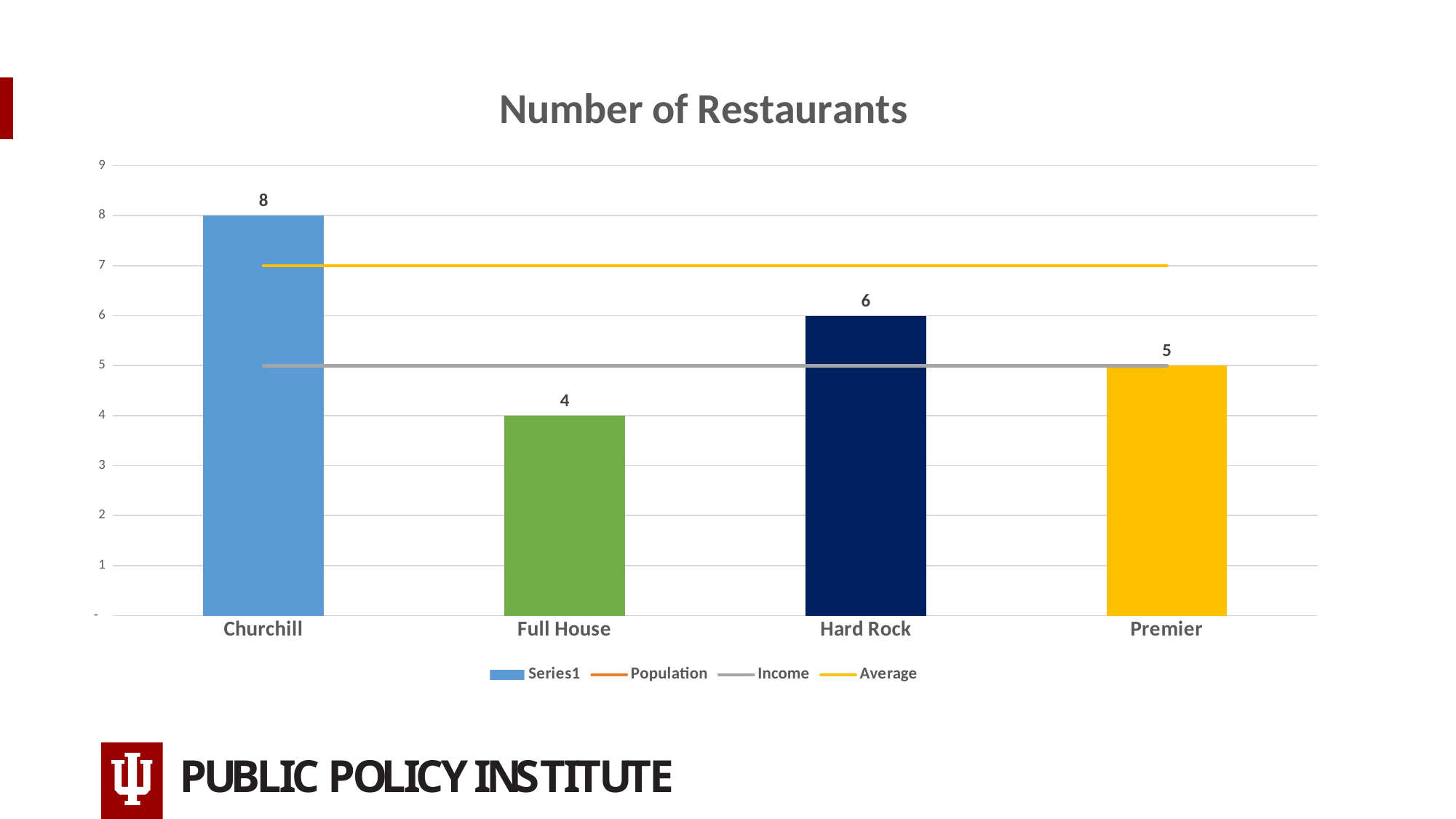
How many series does the legend list? 4 Which has more restaurants, Hard Rock or Premier? Hard Rock What is the difference between the number of restaurants for Churchill and Full House? 4 What is the number of restaurants for Churchill? 8 How many categories are shown on the x axis? 4 Which category has the highest number of restaurants? Churchill What is the number of restaurants for Full House? 4 Which category has the lowest number of restaurants? Full House What is the title of the chart? Number of Restaurants What is the number of restaurants for Premier? 5 What is the number of restaurants for Hard Rock? 6 Is the value for Full House greater or less than 5? less